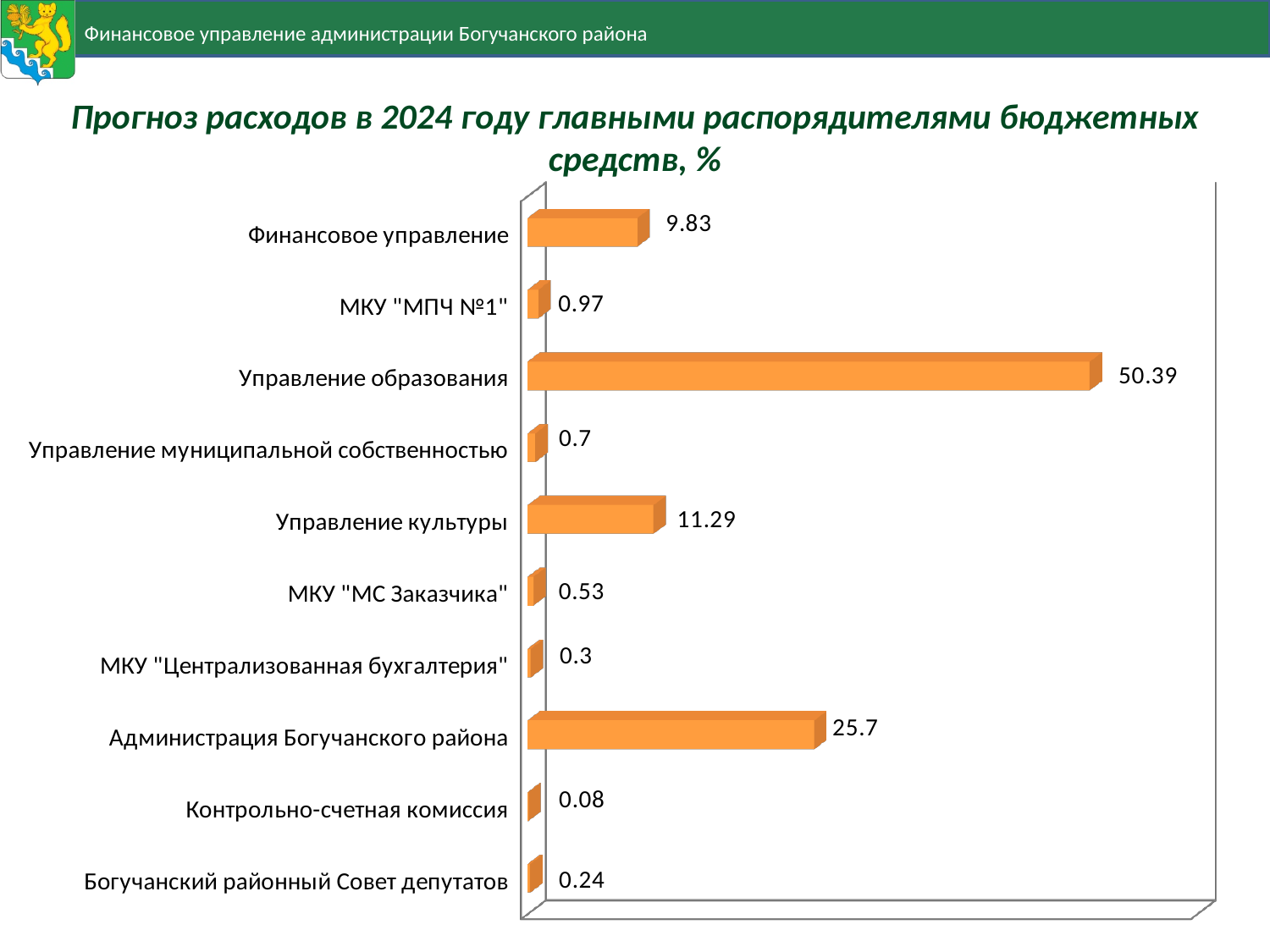
What is the title of the chart? Прогноз расходов в 2024 году главными распорядителями бюджетных средств, % How many categories are shown in the chart? 10 What is the value for Контрольно-счетная комиссия? 0.08 Which category has the highest value? Управление образования What kind of chart is shown on the slide? bar chart Which category has the lowest value? Контрольно-счетная комиссия What is the value for Управление образования? 50.39 What is the value for Управление культуры? 11.29 Which is larger, the value for Финансовое управление or the value for Управление культуры? Управление культуры What is the difference between the values for МКУ "МПЧ №1" and МКУ "МС Заказчика"? 0.44 What is the value for Администрация Богучанского района? 25.7 What is the difference between the values for Управление образования and Администрация Богучанского района? 24.69